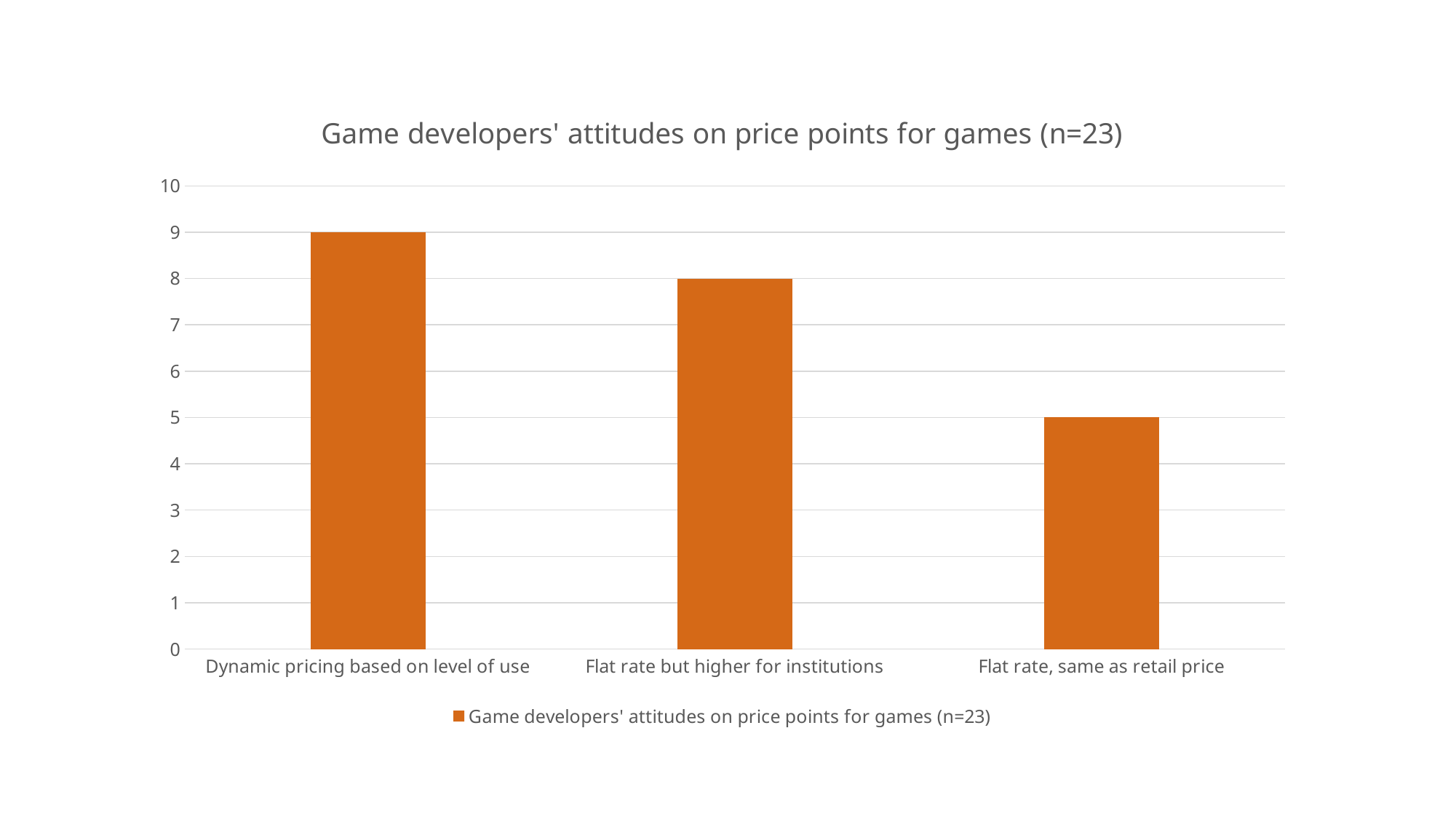
Which is larger: the value for 'Flat rate but higher for institutions' or 'Flat rate, same as retail price'? Flat rate but higher for institutions What is the value for 'Flat rate, same as retail price'? 5 What is the difference between the values for 'Dynamic pricing based on level of use' and 'Flat rate, same as retail price'? 4 What is the value for 'Flat rate but higher for institutions'? 8 What is the title of the chart? Game developers' attitudes on price points for games (n=23) Is the value for 'Flat rate, same as retail price' greater or less than 6? less Do the values rise or fall from left to right along the x axis? Fall What is the value for 'Dynamic pricing based on level of use'? 9 What kind of chart is shown on the slide? Bar chart How many categories are shown on the x axis? 3 Which category has the highest value? Dynamic pricing based on level of use Which category has the lowest value? Flat rate, same as retail price